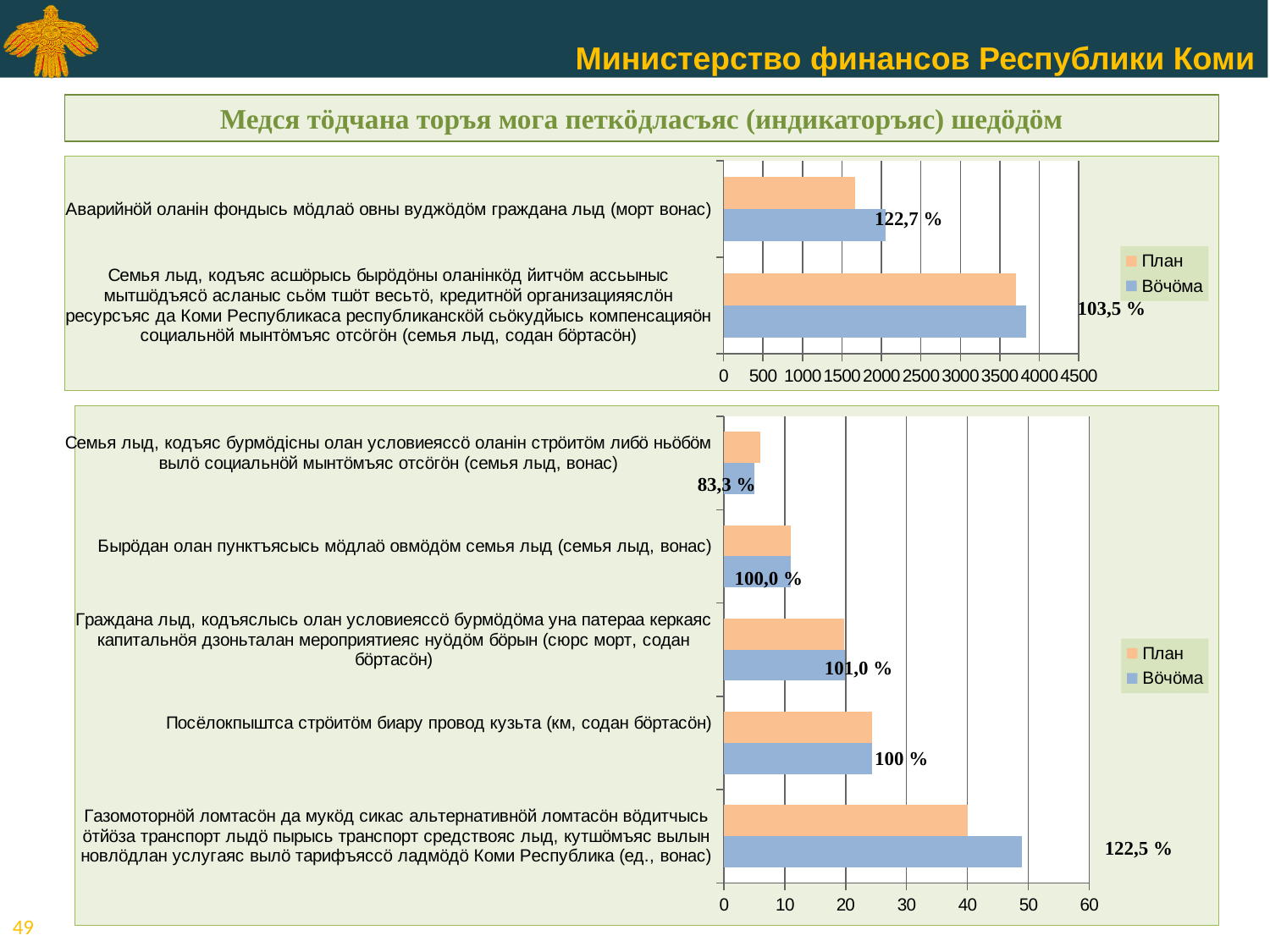
In the top chart, what percentage label is shown for the category 'Семья лыд, кодъяс асшöрысь бырöдöны оланінкöд йитчöм ассьыныс мытшöдъясö...'? 103,5 % How many series does the legend of the bottom chart list? 2 In the bottom chart, what percentage label is shown for the category 'Газомоторнöй ломтасöн да мукöд сикас альтернативнöй ломтасöн...'? 122,5 % In the bottom chart, which category has the lowest План value? Семья лыд, кодъяс бурмöдісны олан условиеяссö оланін стрöитöм либö ньöбöм вылö социальнöй мынтöмъяс отсöгöн In the bottom chart, what percentage label is shown for the category 'Семья лыд, кодъяс бурмöдісны олан условиеяссö оланін стрöитöм либö ньöбöм вылö...'? 83,3 % In the top chart, what percentage label is shown for the category 'Аварийнöй оланін фондысь мöдлаö овны вуджöдöм граждана лыд'? 122,7 % How many categories are shown in the bottom chart? 5 How many categories are shown in the top chart? 2 In the bottom chart, for the category 'Газомоторнöй ломтасöн...', which is larger, the План value or the Вöчöма value? Вöчöма In the bottom chart, which category has the highest Вöчöма value? Газомоторнöй ломтасöн да мукöд сикас альтернативнöй ломтасöн вöдитчысь öтйöза транспорт лыдö пырысь транспорт средствояс лыд What type of chart is the top chart on the slide? bar chart In the top chart, for the category 'Аварийнöй оланін фондысь мöдлаö овны вуджöдöм граждана лыд', is the Вöчöма value greater or less than 1500? greater